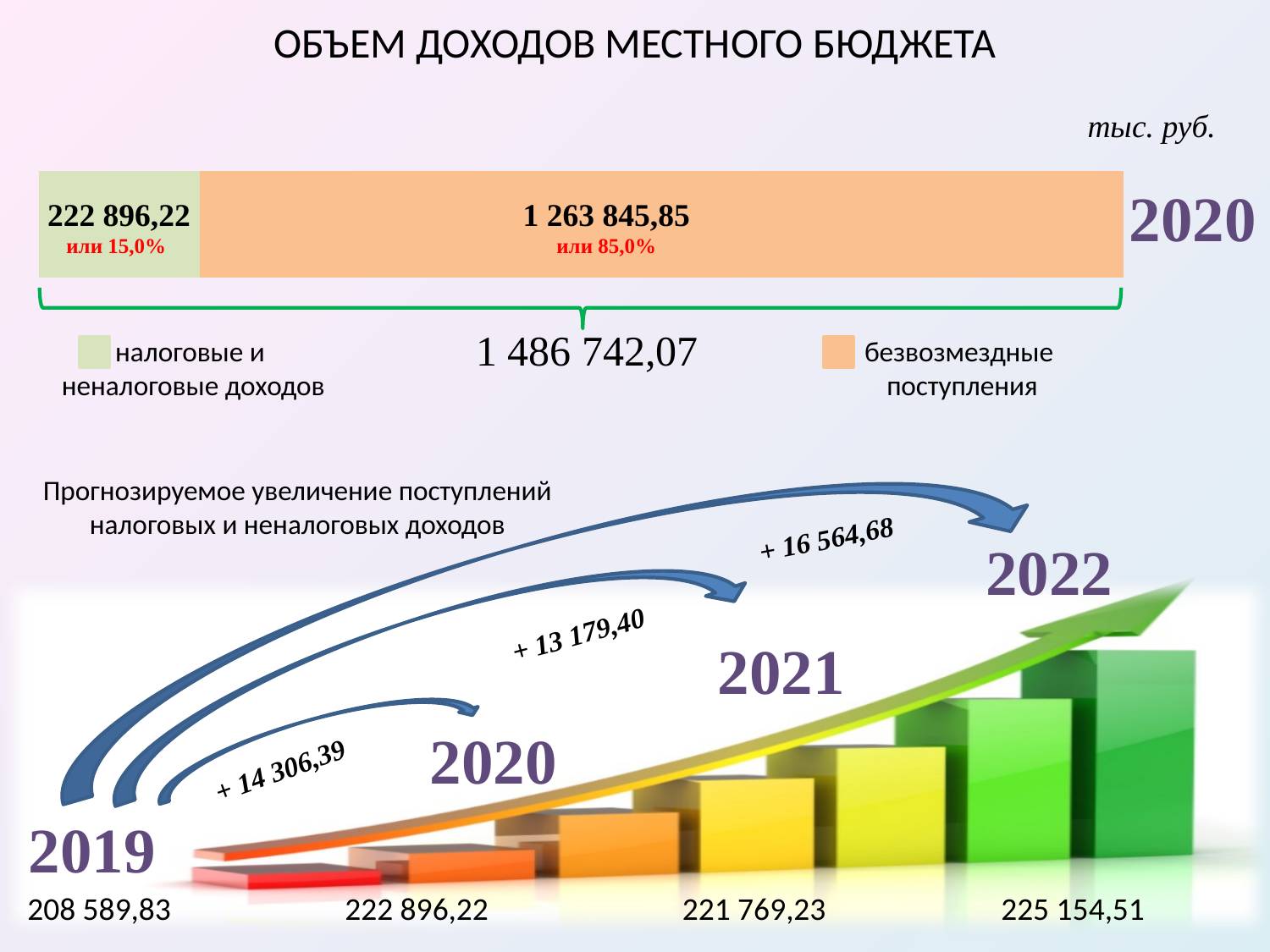
In the top stacked bar for 2020, what share of the total do налоговые и неналоговые доходы make up? 15,0% In the top stacked bar for 2020, what share of the total do безвозмездные поступления make up? 85,0% In the bottom chart of налоговые и неналоговые доходы by year, which year has the lowest value? 2019 In the top stacked bar for 2020, what is the value of безвозмездные поступления? 1 263 845,85 In the bottom chart of налоговые и неналоговые доходы by year, which year has the highest value? 2022 In the top stacked bar for 2020, what is the total of the two segments? 1 486 742,07 In the bottom chart of налоговые и неналоговые доходы by year, what is the value for 2022? 225 154,51 In the top stacked bar for 2020, which segment is larger: налоговые и неналоговые доходы or безвозмездные поступления? безвозмездные поступления In the bottom chart of налоговые и неналоговые доходы by year, how much higher is the 2022 value than the 2019 value? 16 564,68 In the bottom chart of налоговые и неналоговые доходы by year, how many years are shown? 4 In the top stacked bar for 2020, what is the value of налоговые и неналоговые доходы? 222 896,22 In the bottom chart of налоговые и неналоговые доходы by year, what is the value for 2019? 208 589,83